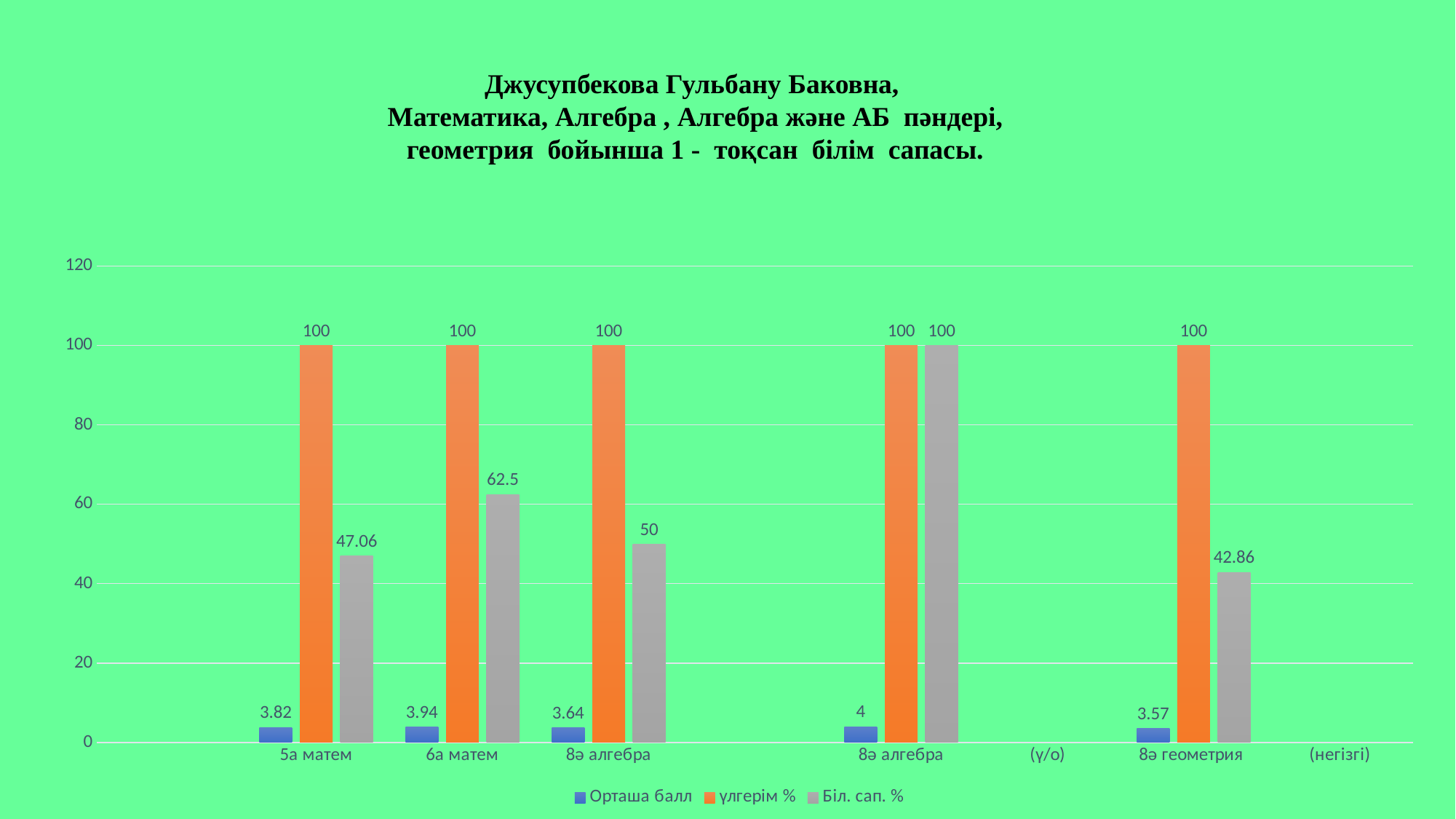
Which category has the lowest Біл. сап. % value? 8ә геометрия Which has the larger Біл. сап. % value, 6а матем or 8ә геометрия? 6а матем What is the үлгерім % value for 5а матем? 100 How many series does the legend list? 3 Which category has the lowest Орташа балл value? 8ә геометрия What is the Орташа балл value for 8ә геометрия? 3.57 What kind of chart is shown on the slide? bar chart What is the difference between the Біл. сап. % values for 6а матем and 5а матем? 15.44 What is the Біл. сап. % value for 8ә геометрия? 42.86 What is the Орташа балл value for 5а матем? 3.82 What is the Біл. сап. % value for 6а матем? 62.5 What is the difference between the Орташа балл values for 6а матем and 5а матем? 0.12